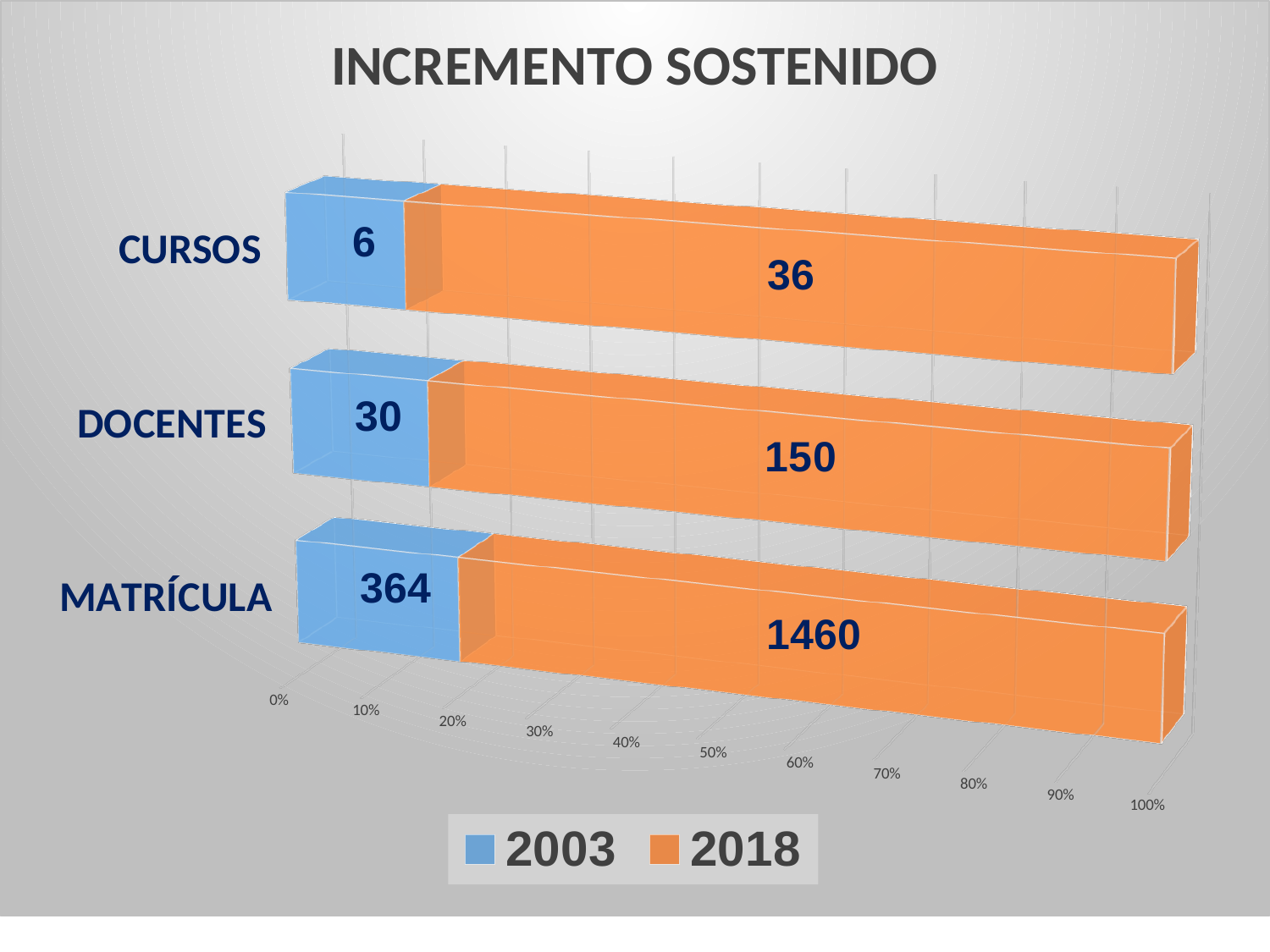
Which category has the highest value in the 2018 series? MATRÍCULA How many series does the legend list? 2 What is the value for MATRÍCULA in the 2003 series? 364 What is the value for MATRÍCULA in the 2018 series? 1460 Which category has the lowest value in the 2003 series? CURSOS What is the difference between the 2018 and 2003 values for DOCENTES? 120 How many categories are shown on the chart? 3 What is the value for CURSOS in the 2003 series? 6 What is the title of the chart? INCREMENTO SOSTENIDO What is the value for DOCENTES in the 2018 series? 150 Which is larger for CURSOS: the 2003 value or the 2018 value? 2018 What kind of chart is shown on the slide? Bar chart